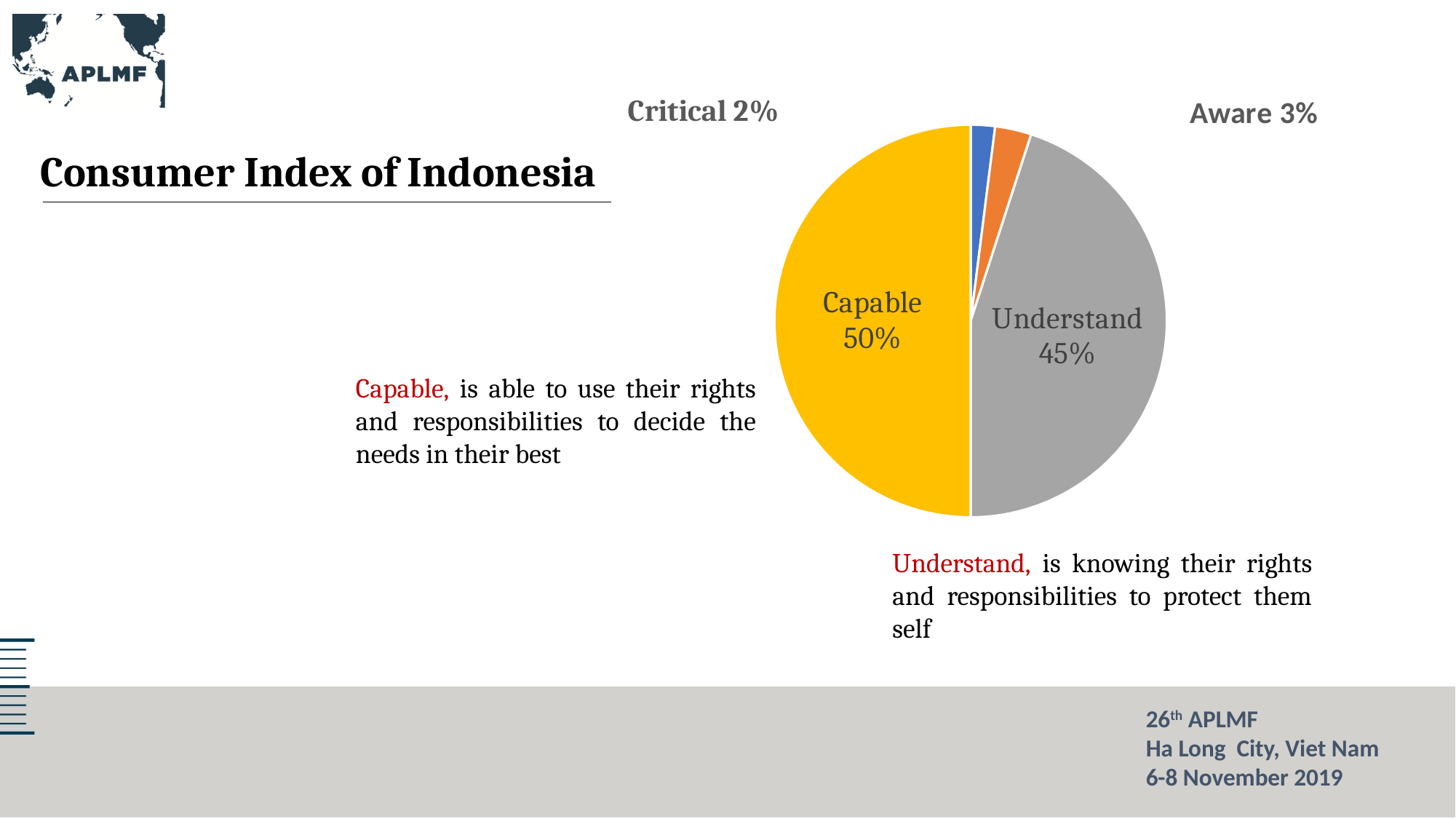
Which is larger, Aware or Critical? Aware Which category has the smallest slice of the pie? Critical How many slices does the pie chart have? 4 What is the value shown for Critical? 2% What is the value shown for Understand? 45% What is the difference between the Capable and Understand percentages? 5% What colour is the Understand slice? grey What is the value shown for Aware? 3% What is the title of the slide containing the pie chart? Consumer Index of Indonesia What share of the pie does the Capable slice represent? 50% What kind of chart is shown on the slide? pie chart Which category has the largest slice of the pie? Capable